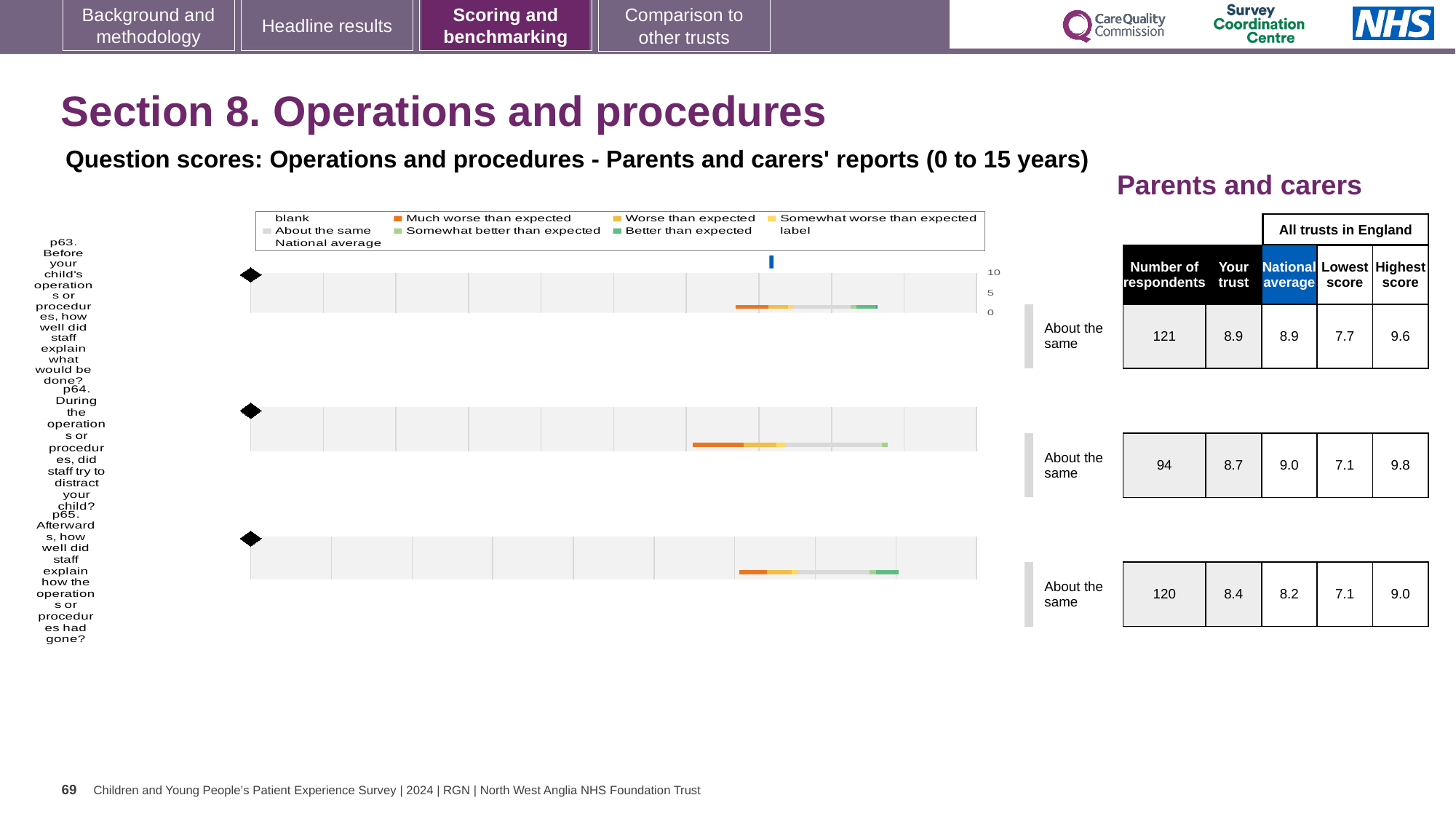
What is the 'Your trust' score for p63 (Before your child's operations or procedures, how well did staff explain what would be done?)? 8.9 What is the highest score across all trusts in England for p64? 9.8 For p65, which is larger: the 'Your trust' score or the national average? Your trust What kind of chart is used to show the question scores on this slide? Bar chart What is the lowest score across all trusts in England for p63? 7.7 Which question has the highest 'Your trust' score on this slide? p63 How many respondents answered p65 (Afterwards, how well did staff explain how the operations or procedures had gone?)? 120 What is the difference between the national average and the 'Your trust' score for p64? 0.3 How many questions are plotted on this slide? 3 Which question has the lowest 'Your trust' score on this slide? p65 What benchmark category is shown for p64 next to its chart? About the same What is the national average score for p64 (During the operations or procedures, did staff try to distract your child?)? 9.0